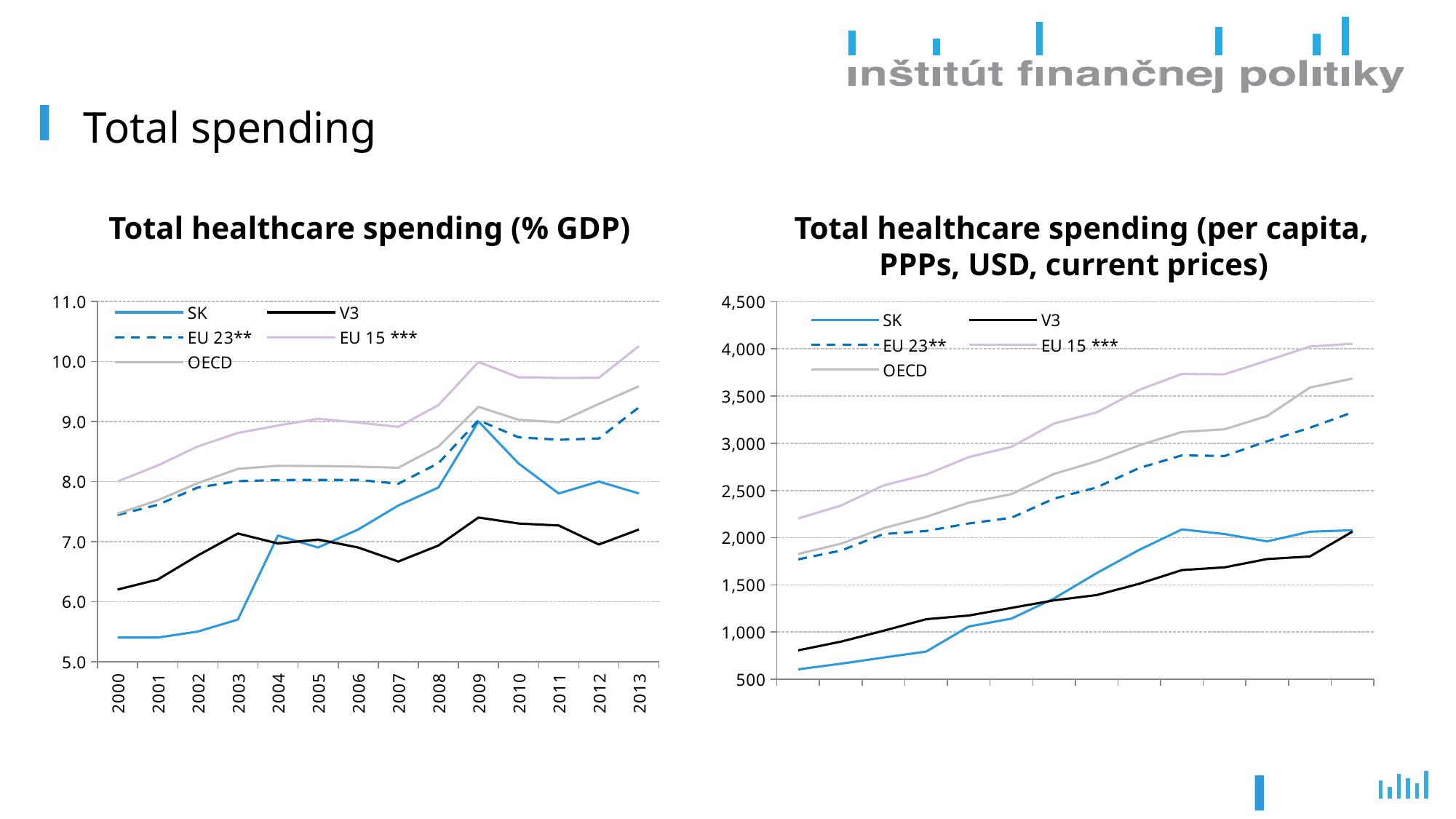
In the 'Total healthcare spending (per capita, PPPs, USD, current prices)' chart, does the EU 15 *** line generally rise or fall from left to right? rise In the 'Total healthcare spending (% GDP)' chart, which series has the highest value in 2013? EU 15 *** In the 'Total healthcare spending (% GDP)' chart, which is larger in 2009, SK or V3? SK How many years are shown on the x axis of the 'Total healthcare spending (% GDP)' chart? 14 How many series does the legend of the 'Total healthcare spending (% GDP)' chart list? 5 What kind of chart is the 'Total healthcare spending (% GDP)' chart on the left? line chart In the 'Total healthcare spending (% GDP)' chart, is the EU 15 *** value in 2013 greater or less than 10.0? greater In the 'Total healthcare spending (% GDP)' chart, in which year does the SK line reach its highest value? 2009 In the 'Total healthcare spending (per capita, PPPs, USD, current prices)' chart, is the first SK value greater or less than 1,000? less In the 'Total healthcare spending (per capita, PPPs, USD, current prices)' chart on the right, how many series does the legend list? 5 In the 'Total healthcare spending (% GDP)' chart, which series has the lowest value in 2000? SK In the 'Total healthcare spending (% GDP)' chart, is the SK value in 2000 greater or less than 6.0? less